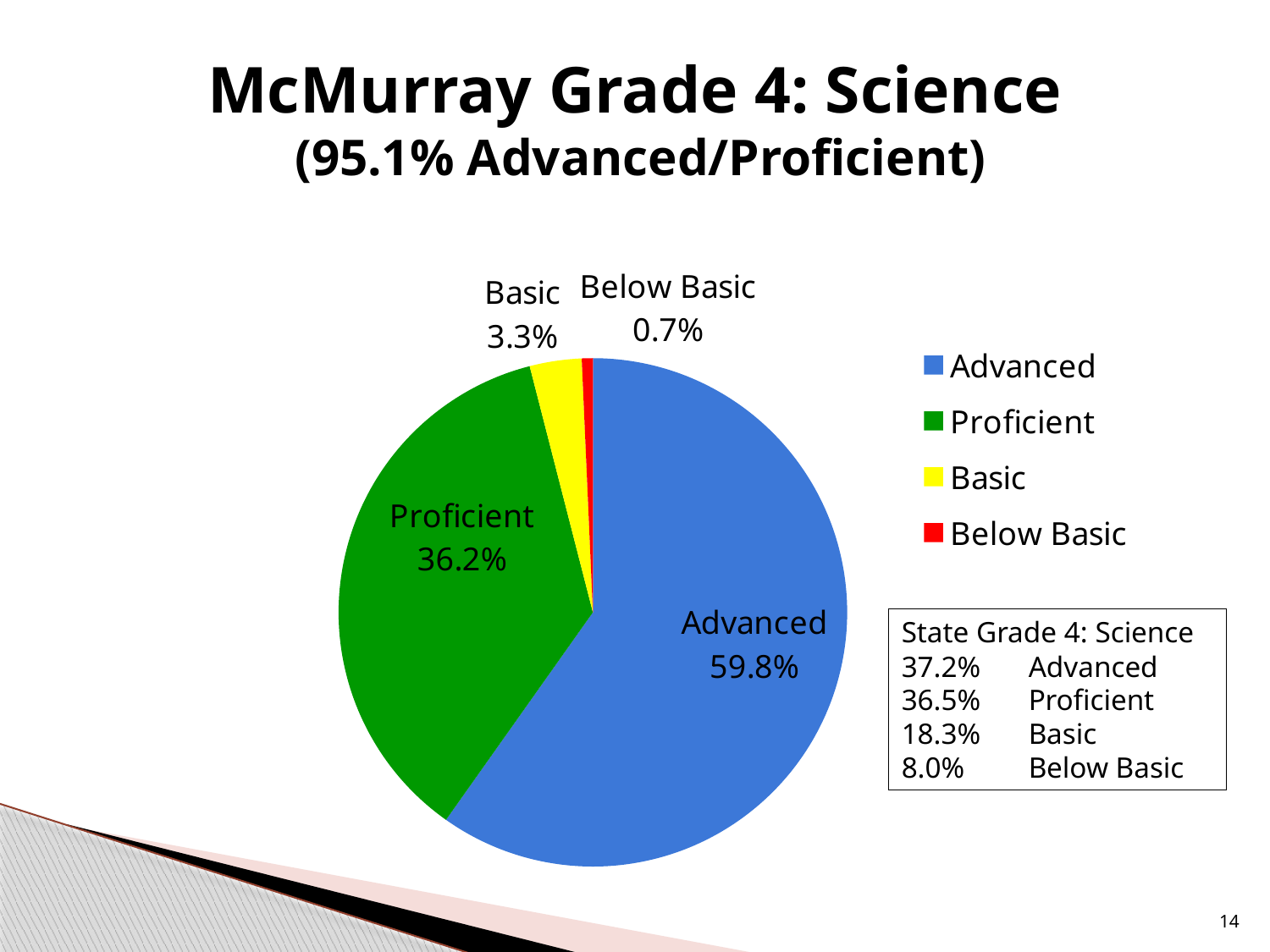
How many entries does the legend list? 4 How many slices does the pie chart have? 4 What percentage of students scored Basic? 3.3% Which is larger, the Basic slice or the Below Basic slice? Basic What is the difference between the Advanced and Proficient percentages? 23.6% Which performance level has the largest share of the pie? Advanced What percentage of McMurray Grade 4 students scored Advanced in Science? 59.8% What colour is the Proficient slice? green What percentage of students scored Below Basic? 0.7% Which performance level has the smallest share of the pie? Below Basic What type of chart is shown on the slide? pie chart What percentage of students scored Proficient? 36.2%